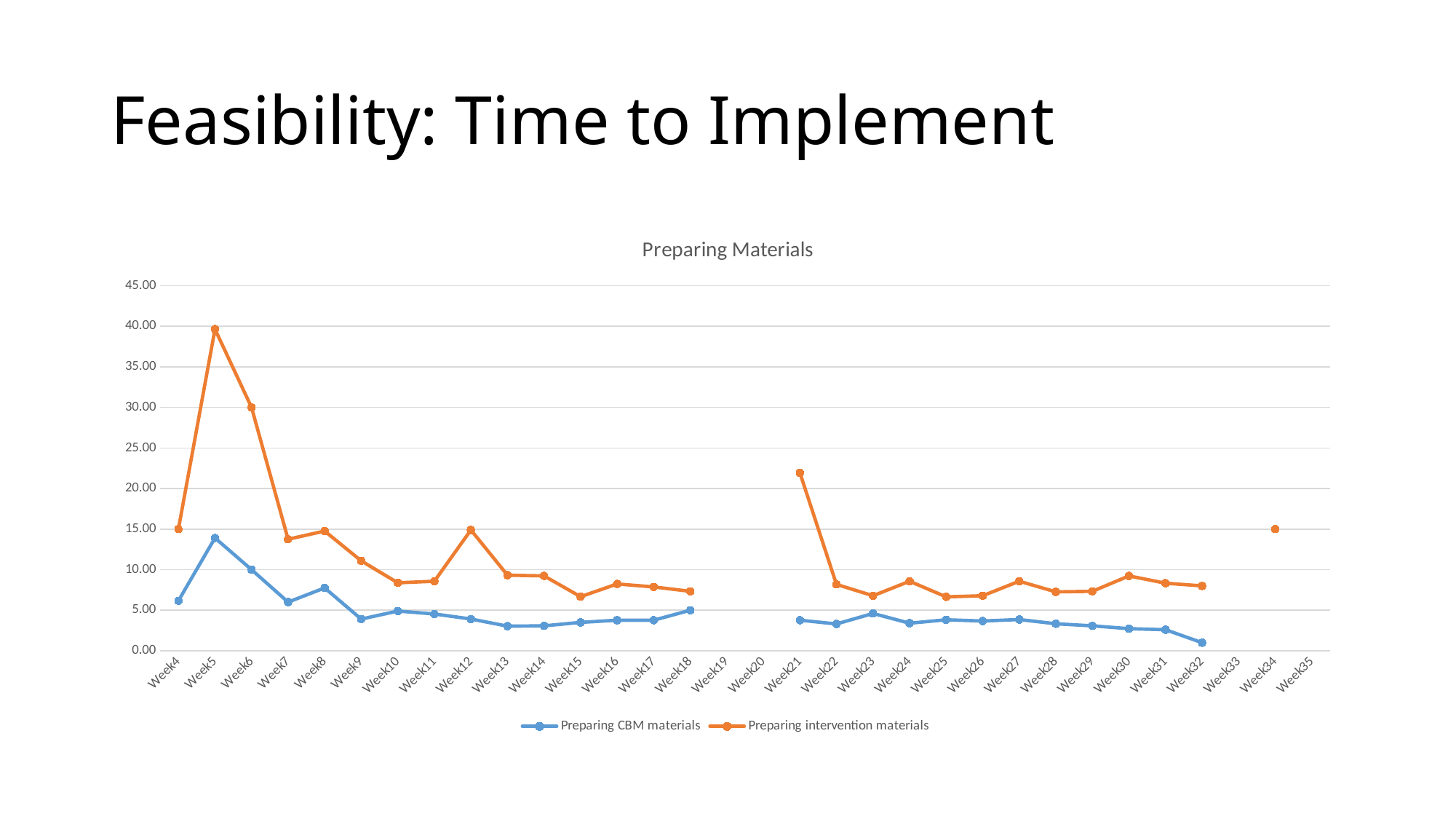
How many series does the legend list? 2 Is the value for Preparing intervention materials at Week5 greater or less than 35.00? greater Which week has the highest value for Preparing CBM materials? Week5 Is the value for Preparing CBM materials at Week32 greater or less than 5.00? less Is the value for Preparing intervention materials at Week21 greater or less than 20.00? greater Which week has the highest value for Preparing intervention materials? Week5 How many week categories are shown on the x axis? 32 What kind of chart is shown on the slide? line chart Which is larger for Preparing intervention materials: the value at Week5 or the value at Week6? Week5 At Week5, which series has the higher value? Preparing intervention materials What is the title of the chart? Preparing Materials